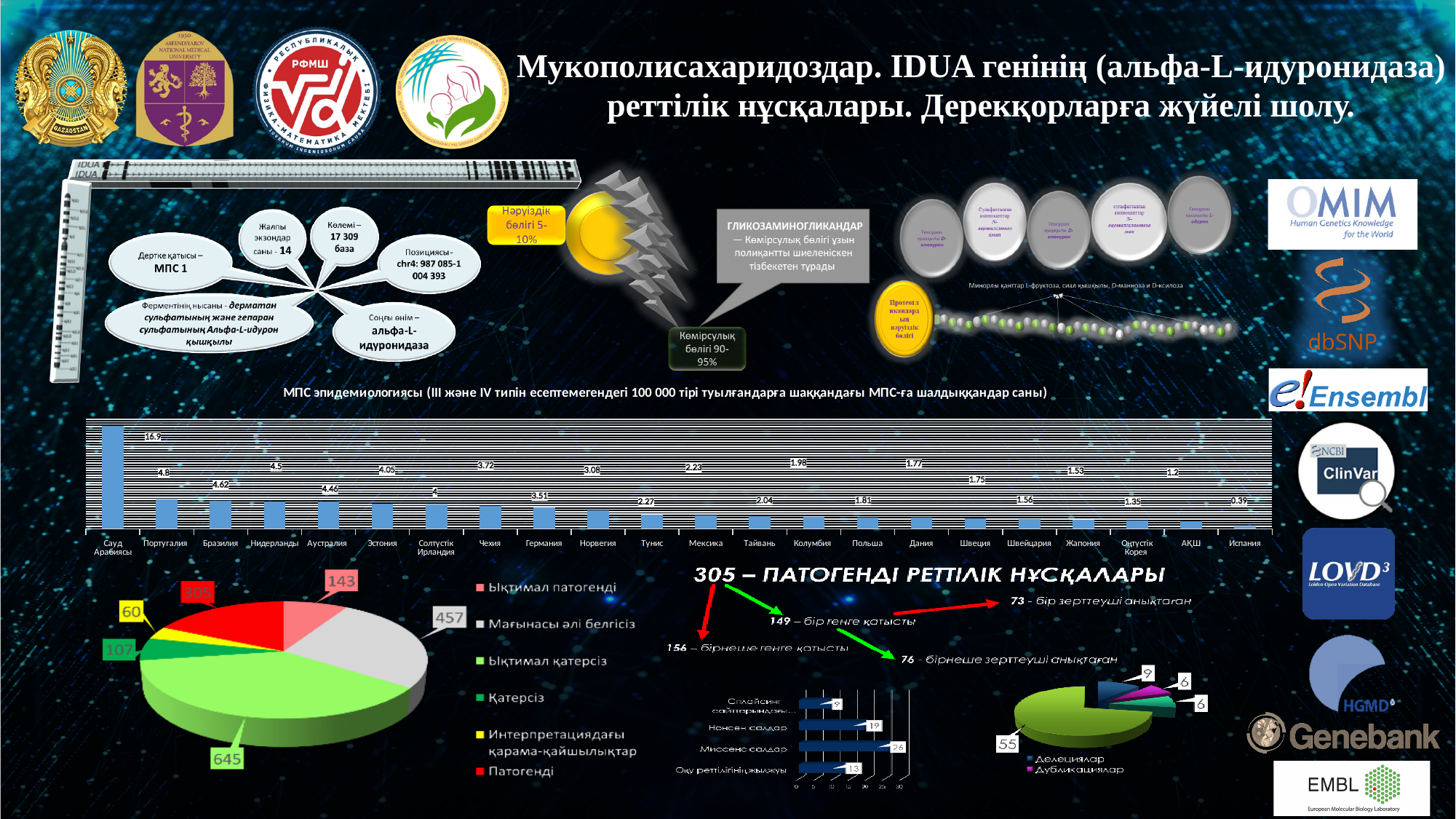
In the bar chart titled 'МПС эпидемиологиясы', what is the value for Сауд Арабиясы? 16.9 In the bar chart titled 'МПС эпидемиологиясы', how many countries are shown on the x axis? 22 In the bar chart titled 'МПС эпидемиологиясы', which country has the highest value? Сауд Арабиясы In the pie chart at the bottom left of the slide, what is the difference between the values for Патогенді and Ықтимал патогенді? 162 In the pie chart at the bottom left of the slide, how many categories does the legend list? 6 In the bar chart titled 'МПС эпидемиологиясы', which country has the lowest value? Испания In the bar chart titled 'МПС эпидемиологиясы', what is the difference between the values for Португалия and Испания? 4.41 What kind of chart is the 'МПС эпидемиологиясы' chart? bar chart In the bar chart titled 'МПС эпидемиологиясы', do the values rise or fall from left to right along the x axis? fall In the pie chart at the bottom left of the slide, what is the value for Қатерсіз? 107 In the small horizontal bar chart at the bottom centre of the slide, which category has the highest value? Миссенс салдар In the pie chart at the bottom left of the slide, which category has the largest slice? Ықтимал қатерсіз